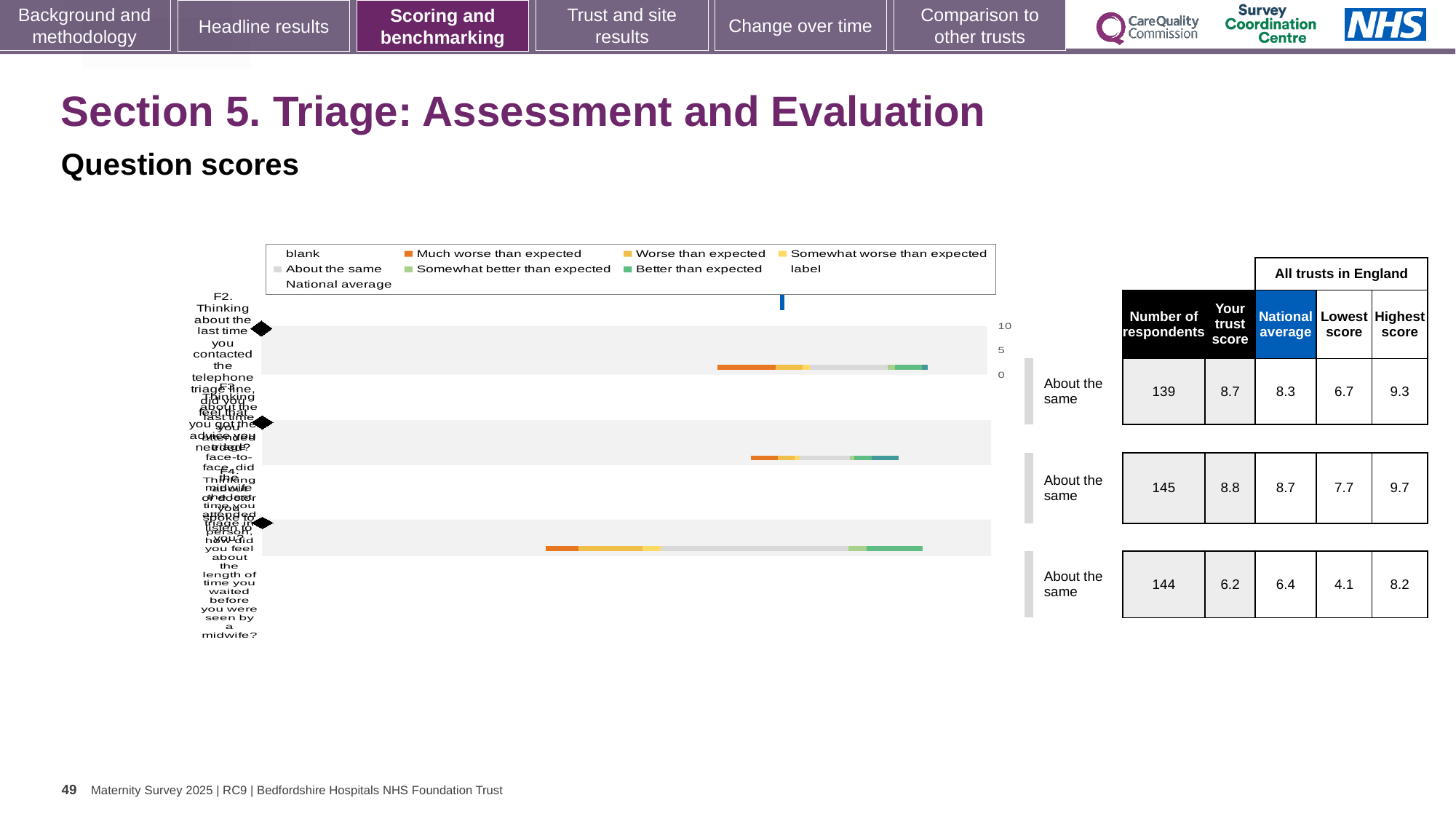
In the table beside the chart, what is the lowest score across all trusts in England for the third row (F4)? 4.1 In the table beside the chart, what is the difference between the national average and the trust score for the third row (F4)? 0.2 In the table beside the chart, which row has the lowest 'Your trust score'? F4 (third row) In the table beside the chart, what is the national average for the third row (F4)? 6.4 In the table beside the chart, which row has the highest 'Your trust score'? F3 (second row) How many question rows (bars) does the chart show? 3 What kind of chart is shown on the slide? bar chart In the table beside the chart, what is the number of respondents for the first row (F2)? 139 In the table beside the chart, what is the trust score for the second row (F3)? 8.8 Which colour does the legend use for 'Much worse than expected'? orange In the table beside the chart, is the trust score for the first row (F2) larger or smaller than its national average? larger What is the highest tick value shown on the chart's axis? 10